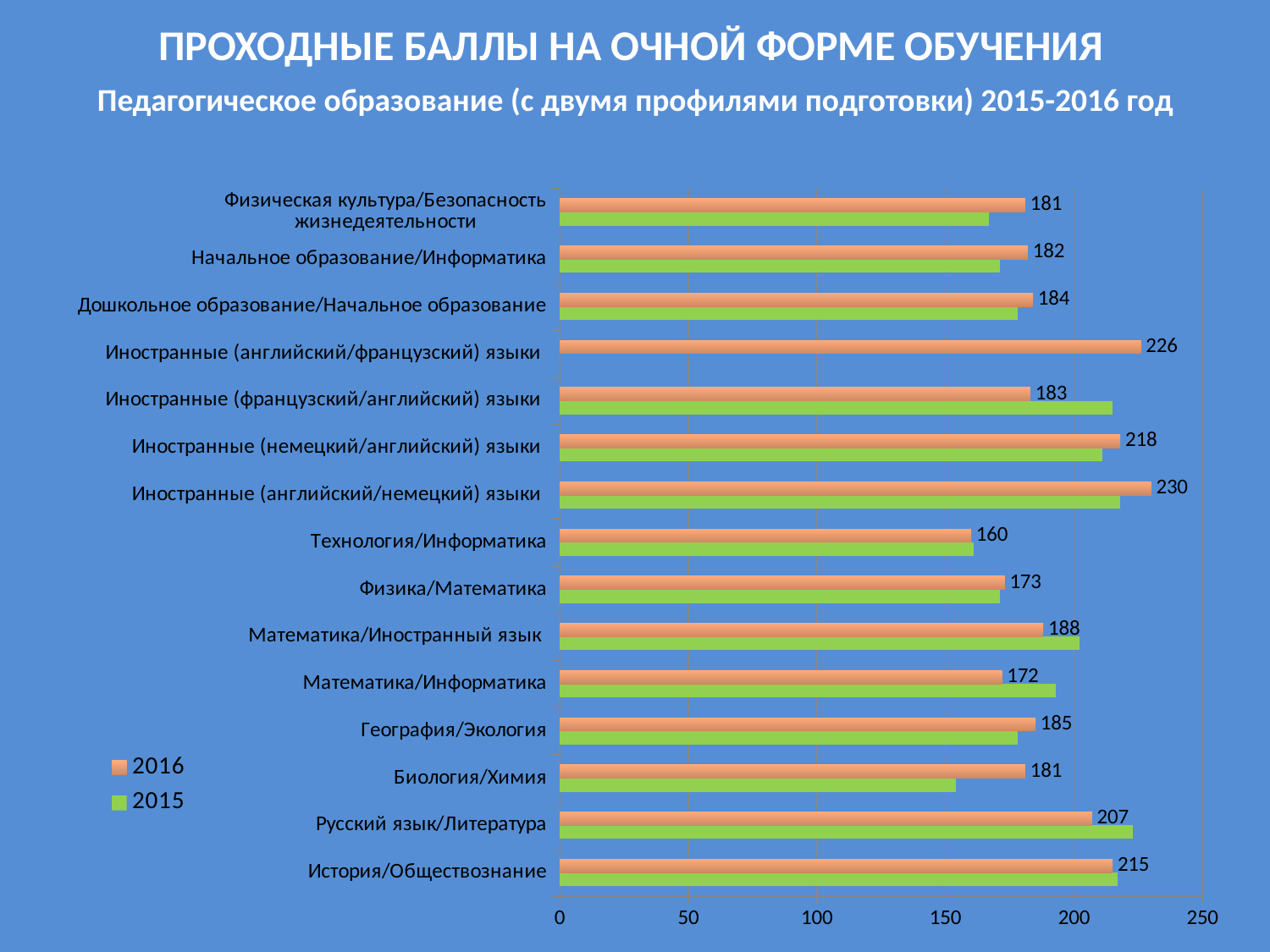
What is the difference between the 2016 values for Иностранные (английский/немецкий) языки and Технология/Информатика? 70 Is the 2015 value for Русский язык/Литература greater or less than 200? greater How many series does the legend list? 2 Which category has the highest 2016 value? Иностранные (английский/немецкий) языки Which has the larger 2016 value: Русский язык/Литература or Математика/Иностранный язык? Русский язык/Литература Is the 2015 value for Биология/Химия greater or less than 200? less What is the 2016 value for Русский язык/Литература? 207 What is the 2016 value for Иностранные (английский/немецкий) языки? 230 Which category has the lowest 2016 value? Технология/Информатика What is the 2016 value for Технология/Информатика? 160 What is the 2016 value for История/Обществознание? 215 How many categories are shown on the chart? 15